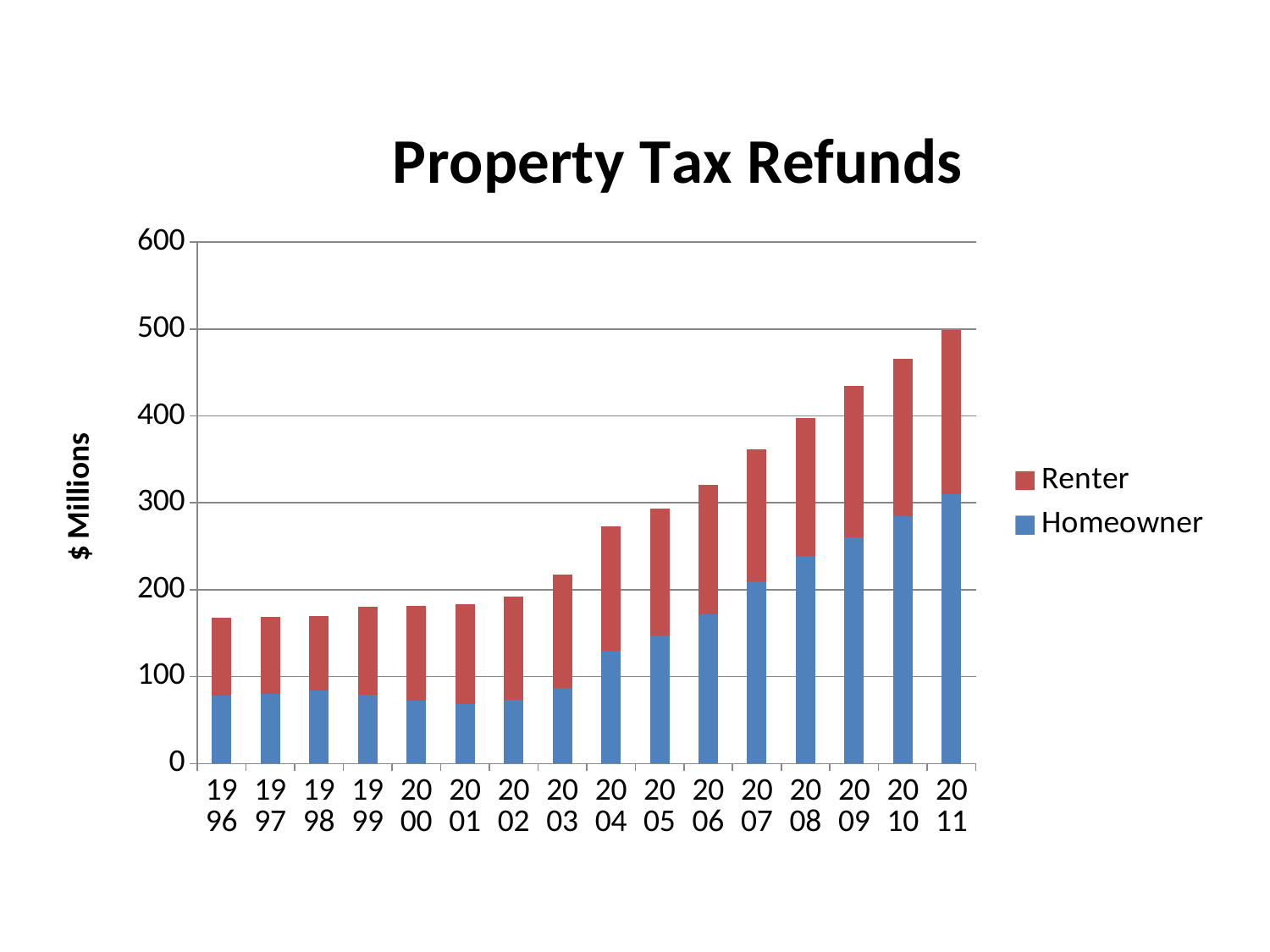
Which is larger, the Homeowner value for 2010 or the Homeowner value for 2000? 2010 Do total property tax refunds generally rise or fall from 1996 to 2011? rise Is the total value for 2007 greater or less than 300? greater Is the Homeowner value for 1996 greater or less than 100? less Is the Homeowner value for 2004 greater or less than 100? greater Which year has the highest total property tax refunds? 2011 What is the label on the vertical axis? $ Millions How many series does the legend list? 2 What is the title of the chart? Property Tax Refunds What kind of chart is shown on the slide? stacked bar chart How many years are shown on the x axis? 16